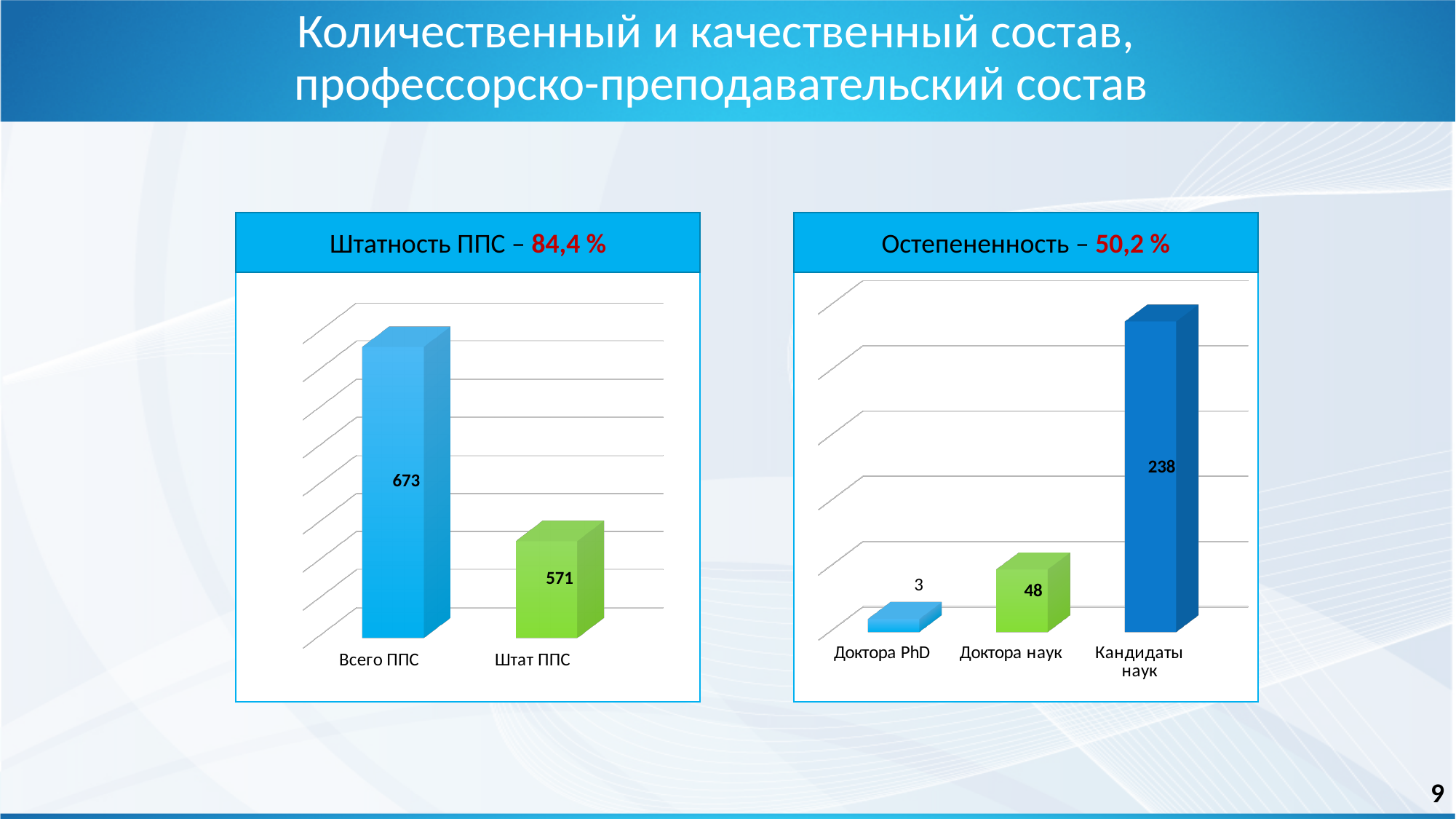
In the left chart (Штатность ППС), what is the value for Всего ППС? 673 In the right chart (Остепененность), what is the difference between Кандидаты наук and Доктора наук? 190 In the right chart (Остепененность), what is the value for Доктора наук? 48 In the right chart (Остепененность), which category has the lowest value? Доктора PhD In the left chart (Штатность ППС), how many bars are plotted? 2 In the left chart (Штатность ППС), what is the value for Штат ППС? 571 In the right chart (Остепененность), how many categories are shown? 3 In the right chart (Остепененность), what is the value for Доктора PhD? 3 In the left chart (Штатность ППС), what is the difference between Всего ППС and Штат ППС? 102 What percentage is shown in the title of the right chart (Остепененность)? 50,2 % In the right chart (Остепененность), what is the value for Кандидаты наук? 238 In the right chart (Остепененность), which category has the highest value? Кандидаты наук